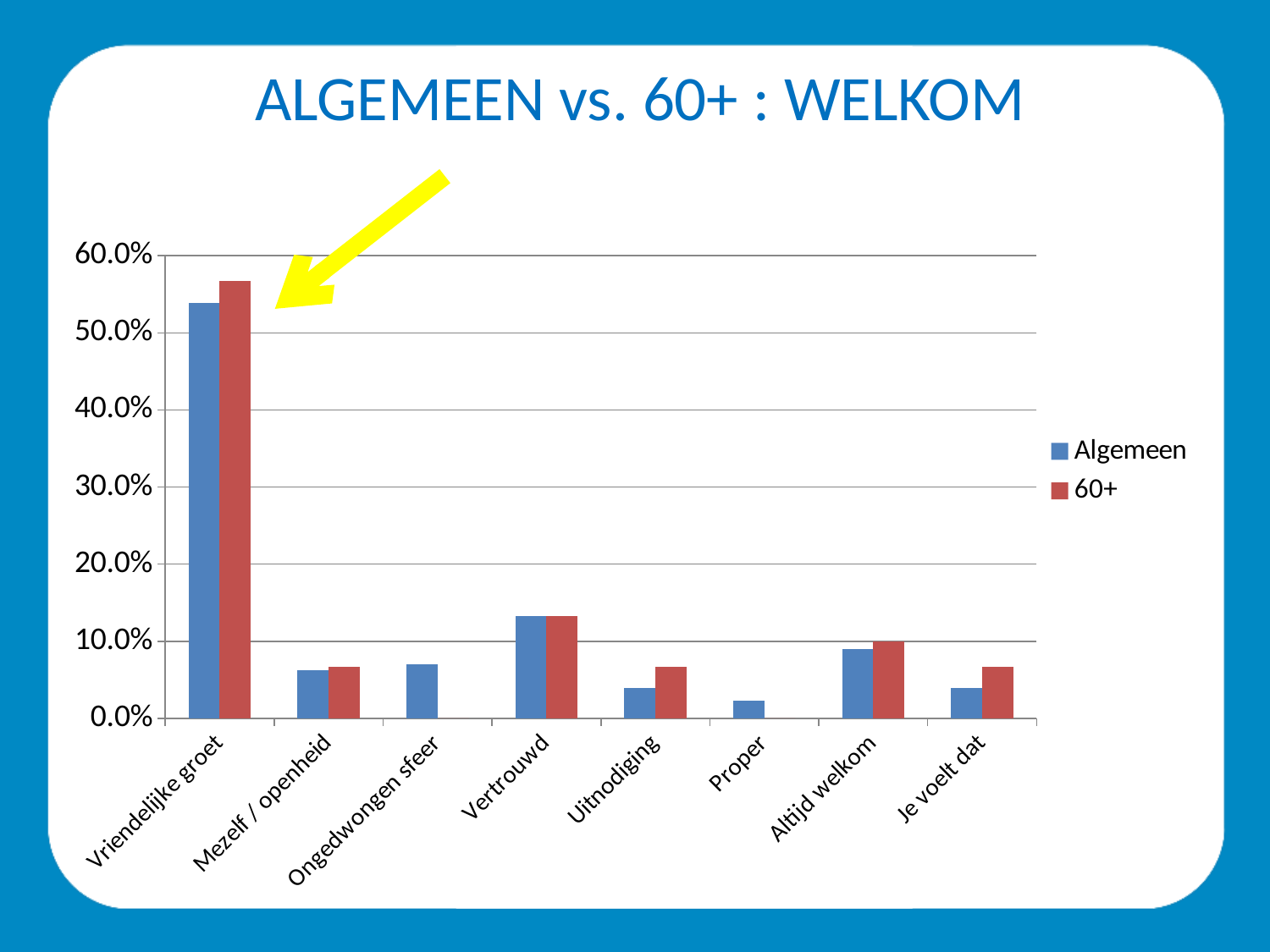
How many series does the legend list? 2 Which category has the highest value for the Algemeen series? Vriendelijke groet For Uitnodiging, which series has the larger value, Algemeen or 60+? 60+ How many categories are shown on the x axis? 8 What kind of chart is shown on the slide? bar chart What is the title of the slide containing the chart? ALGEMEEN vs. 60+ : WELKOM Is the Algemeen value for Vertrouwd greater or less than 10.0%? greater For Vriendelijke groet, which series has the larger value, Algemeen or 60+? 60+ Which category has the highest value for the 60+ series? Vriendelijke groet Is the Algemeen value for Vriendelijke groet greater or less than 50.0%? greater Is the 60+ value for Vriendelijke groet greater or less than 60.0%? less